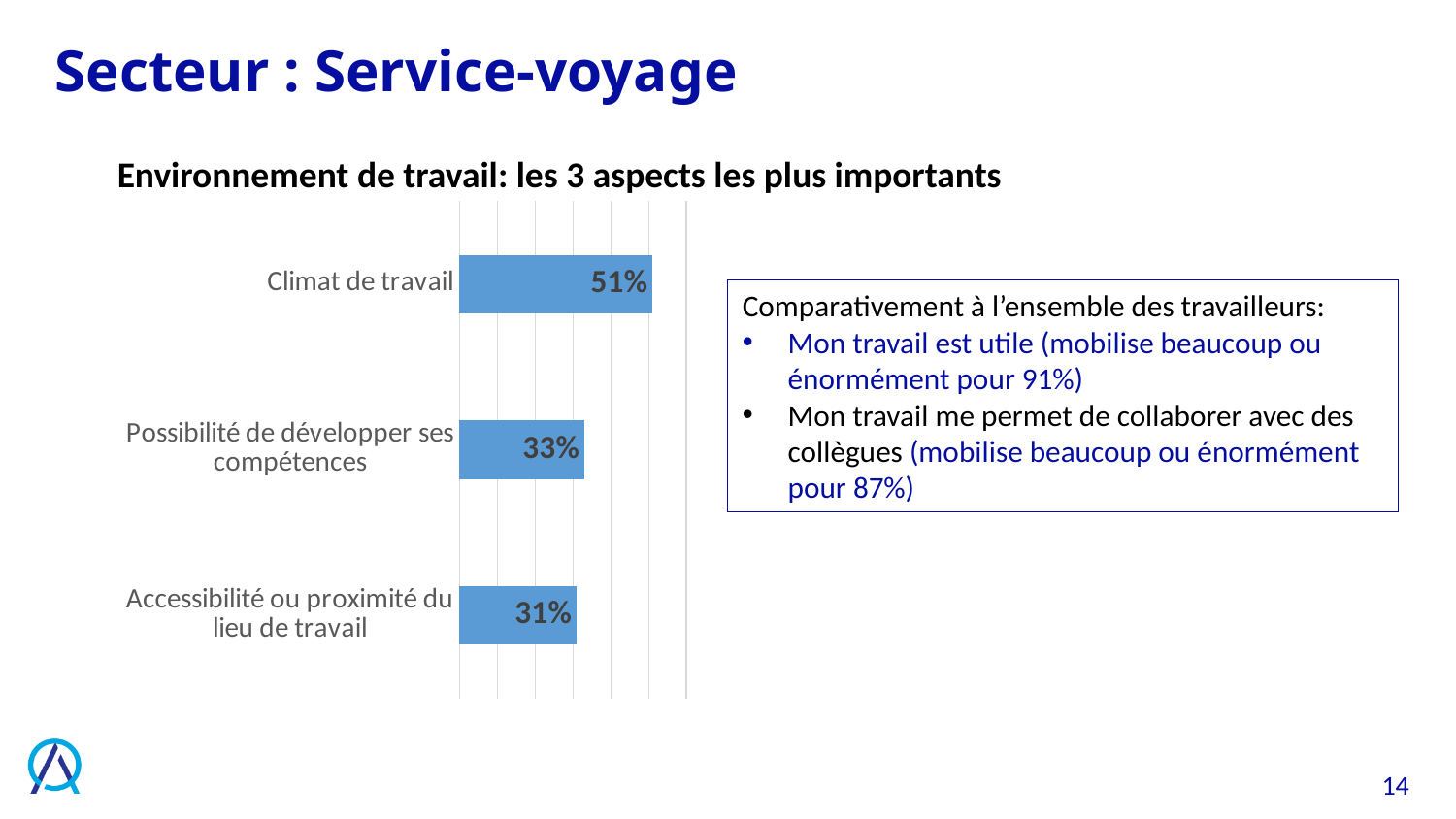
What colour are the bars in the chart? Blue What is the difference between the values for Possibilité de développer ses compétences and Accessibilité ou proximité du lieu de travail? 2% Which category has the lowest value? Accessibilité ou proximité du lieu de travail What is the value for Possibilité de développer ses compétences? 33% Which category has the highest value? Climat de travail How many categories are shown in the chart? 3 What is the value for Climat de travail? 51% Which is larger, the value for Climat de travail or the value for Possibilité de développer ses compétences? Climat de travail What is the title of the chart? Environnement de travail: les 3 aspects les plus importants What kind of chart is shown on the slide? Bar chart What is the value for Accessibilité ou proximité du lieu de travail? 31% What is the difference between the values for Climat de travail and Accessibilité ou proximité du lieu de travail? 20%